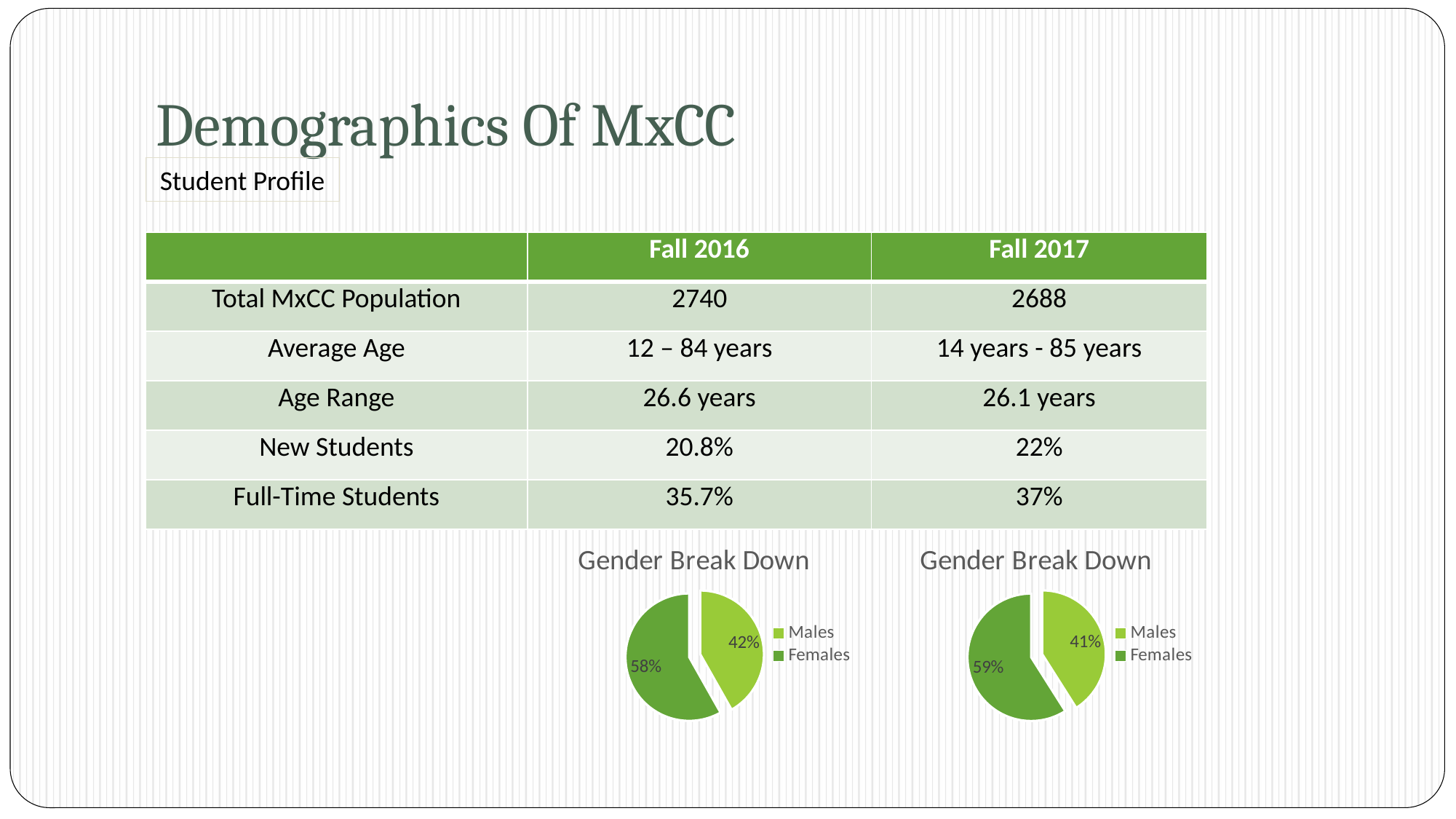
How many entries does the legend of the right Gender Break Down pie chart list? 2 In the left Gender Break Down pie chart, what percentage is Males? 42% In the left Gender Break Down pie chart, what is the difference between the Females and Males percentages? 16% In the right Gender Break Down pie chart, which slice is the smallest? Males In the right Gender Break Down pie chart, what is the difference between the Females and Males percentages? 18% In the left Gender Break Down pie chart, what percentage is Females? 58% In the right Gender Break Down pie chart, what percentage is Females? 59% In the right Gender Break Down pie chart, what percentage is Males? 41% What type of chart is used for the Gender Break Down charts on the slide? Pie chart How many slices does the left Gender Break Down pie chart have? 2 In the left Gender Break Down pie chart, which slice is the largest? Females Which is larger: the Males share in the left Gender Break Down pie chart or the Males share in the right Gender Break Down pie chart? Left (42%)